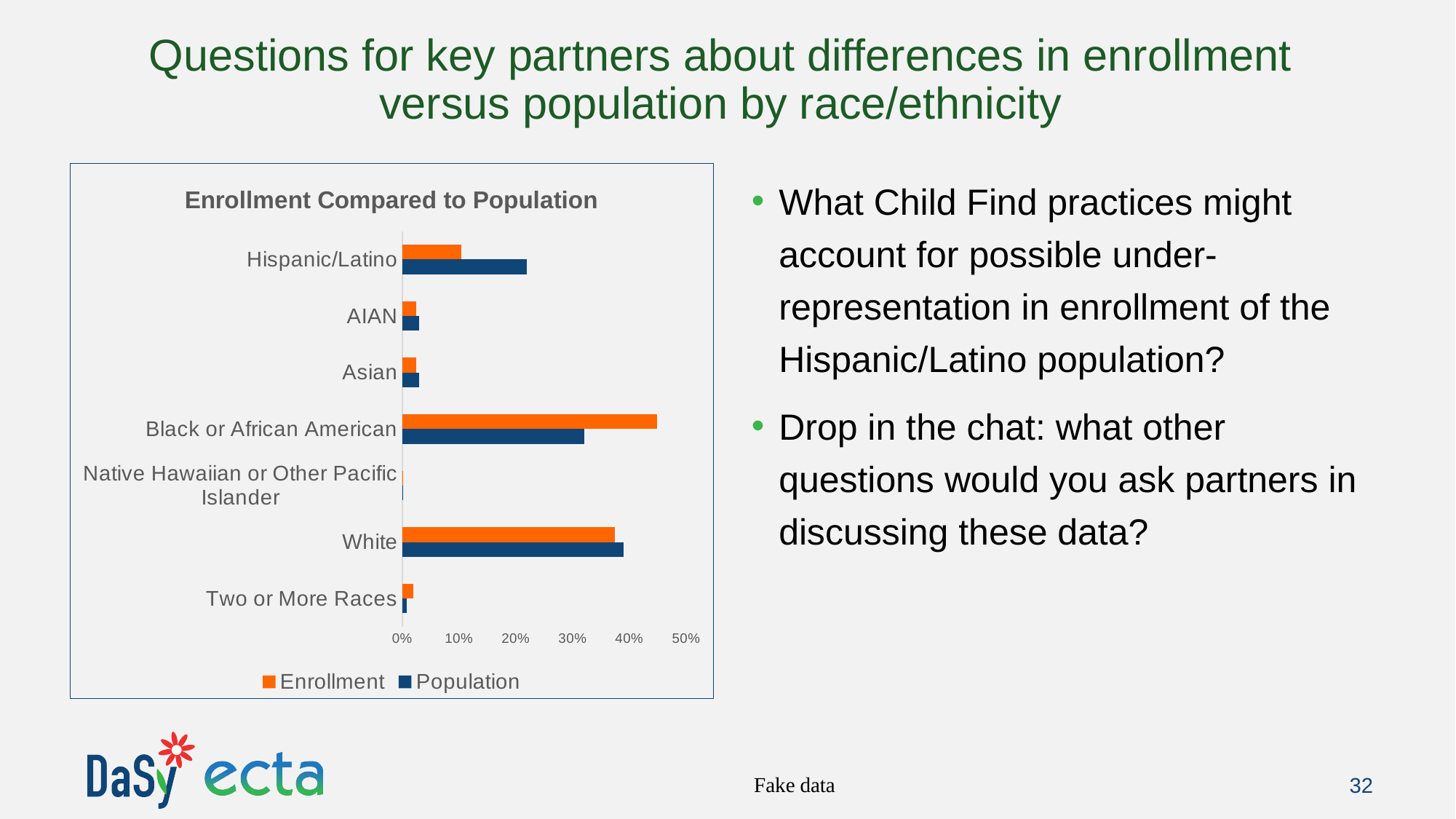
Which series is shown in orange in the chart? Enrollment For Hispanic/Latino, which is larger: Enrollment or Population? Population How many series does the chart legend list? 2 Which category has the highest Population value? White What kind of chart is shown on the slide? bar chart How many race/ethnicity categories are shown on the chart? 7 Is the Enrollment value for Black or African American greater or less than 40%? greater What is the title of the chart? Enrollment Compared to Population Is the Population value for Hispanic/Latino greater or less than 20%? greater Which category has the highest Enrollment value? Black or African American Is the Enrollment value for Hispanic/Latino greater or less than 20%? less For Black or African American, which is larger: Enrollment or Population? Enrollment